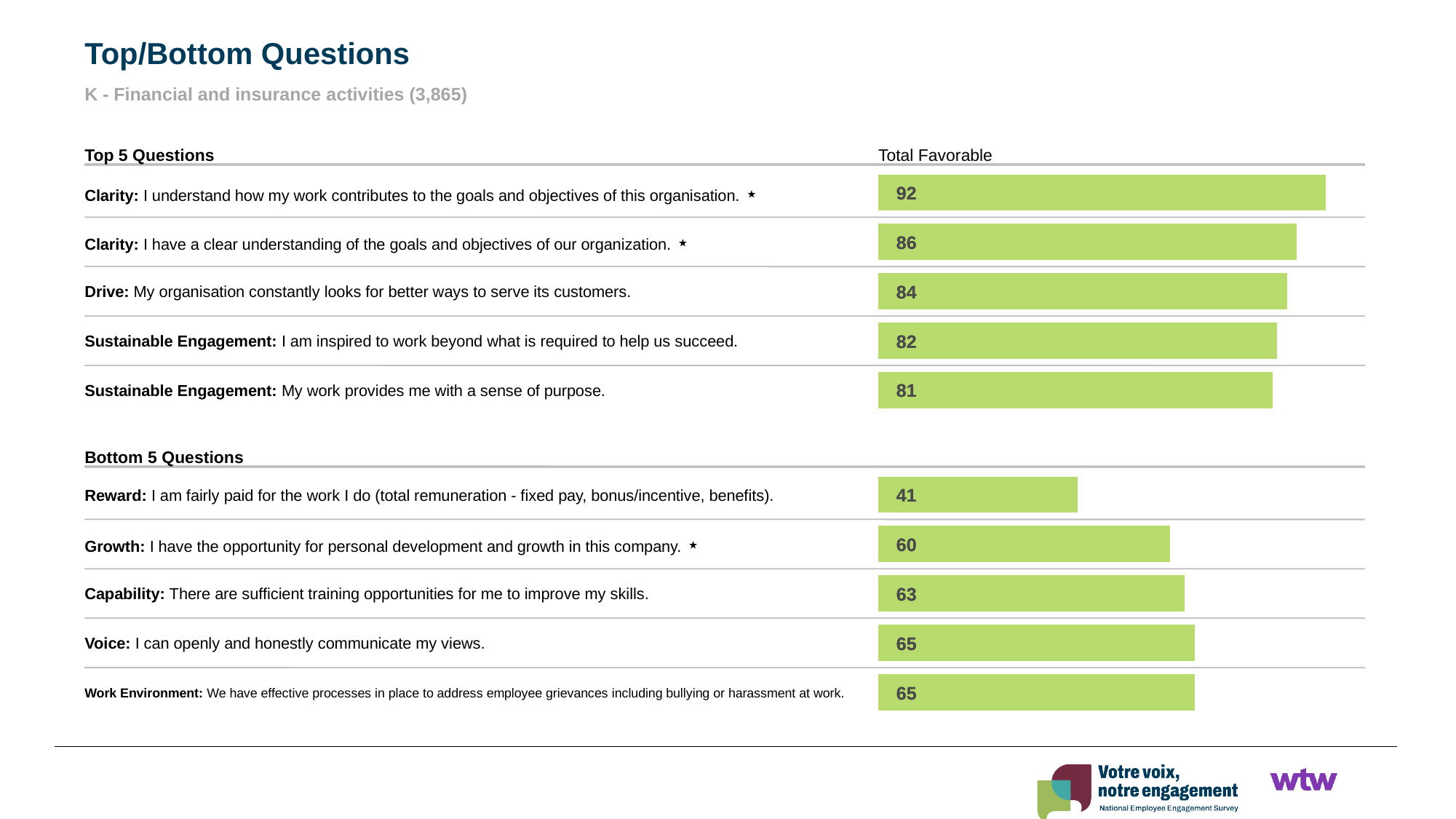
In the Bottom 5 Questions chart, what is the difference between the Total Favorable values for the Voice question and the Reward question? 24 In the Top 5 Questions chart, what is the Total Favorable value for "Drive: My organisation constantly looks for better ways to serve its customers"? 84 What is the column header above the bars on this slide? Total Favorable In the Bottom 5 Questions chart, what is the Total Favorable value for "Capability: There are sufficient training opportunities for me to improve my skills"? 63 In the Bottom 5 Questions chart, what is the Total Favorable value for "Reward: I am fairly paid for the work I do"? 41 In the Top 5 Questions chart, which question has the highest Total Favorable value? Clarity: I understand how my work contributes to the goals and objectives of this organisation. What type of chart is used to show the Total Favorable values on this slide? Bar chart In the Bottom 5 Questions chart, which has a higher Total Favorable value: the Growth question or the Capability question? Capability In the Top 5 Questions chart, what is the difference between the Total Favorable values for the two Clarity questions? 6 How many questions are shown in the Bottom 5 Questions chart? 5 In the Top 5 Questions chart, what is the Total Favorable value for "Clarity: I understand how my work contributes to the goals and objectives of this organisation"? 92 In the Bottom 5 Questions chart, which question has the lowest Total Favorable value? Reward: I am fairly paid for the work I do (total remuneration - fixed pay, bonus/incentive, benefits).